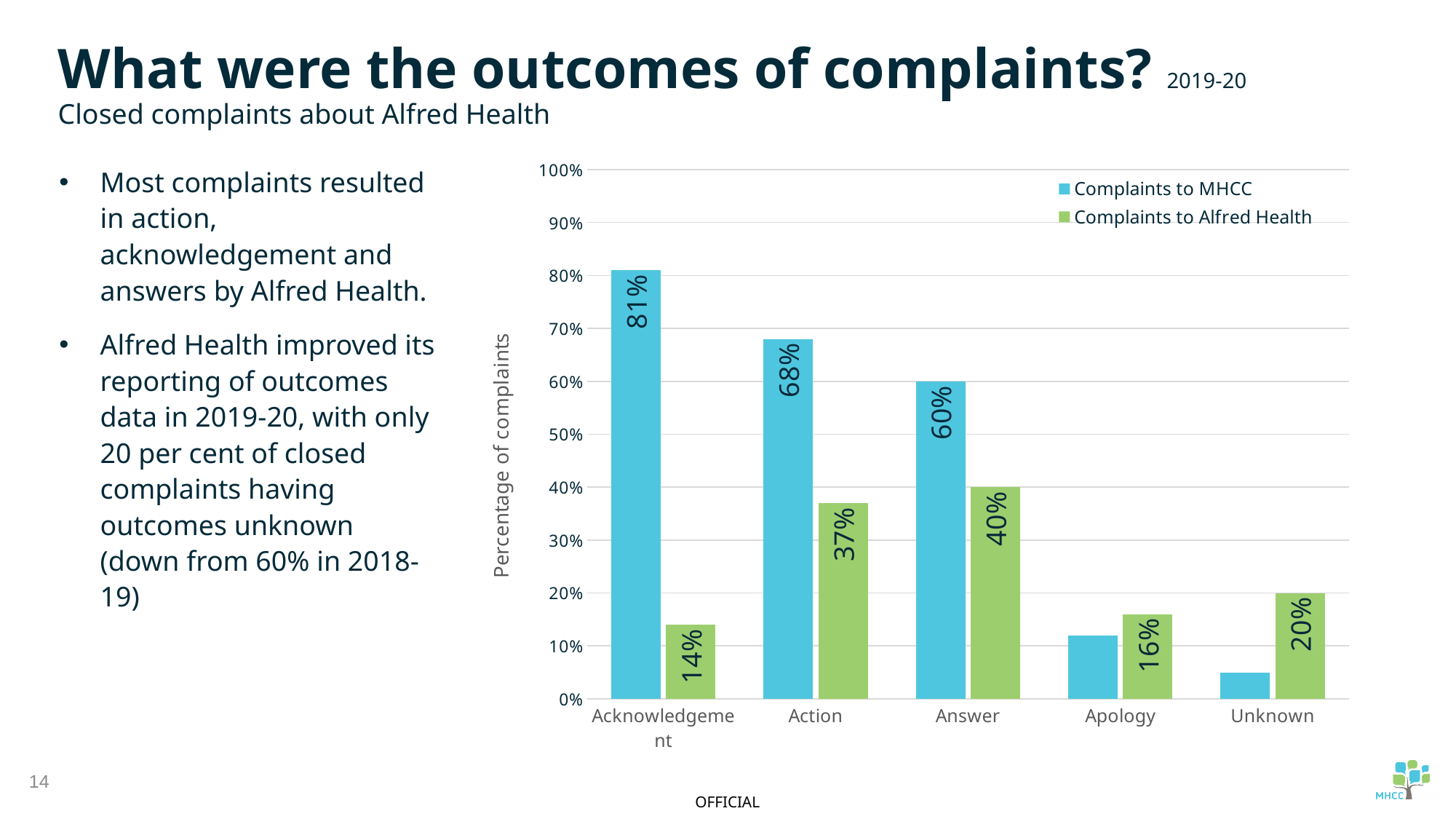
What percentage of complaints to MHCC resulted in Acknowledgement? 81% Is the value for Unknown in the Complaints to MHCC series greater or less than 10%? less For the Action category, what is the difference between Complaints to MHCC and Complaints to Alfred Health? 31 percentage points What kind of chart is shown on the slide? bar chart Which outcome category has the highest value for Complaints to MHCC? Acknowledgement What percentage of complaints to Alfred Health resulted in Answer? 40% Which outcome category has the lowest value for Complaints to Alfred Health? Acknowledgement For the Apology category, which series has the larger value: Complaints to MHCC or Complaints to Alfred Health? Complaints to Alfred Health Which outcome category has the highest value for Complaints to Alfred Health? Answer How many outcome categories are shown on the x axis? 5 What is the value for Unknown in the Complaints to Alfred Health series? 20% How many series does the legend list? 2